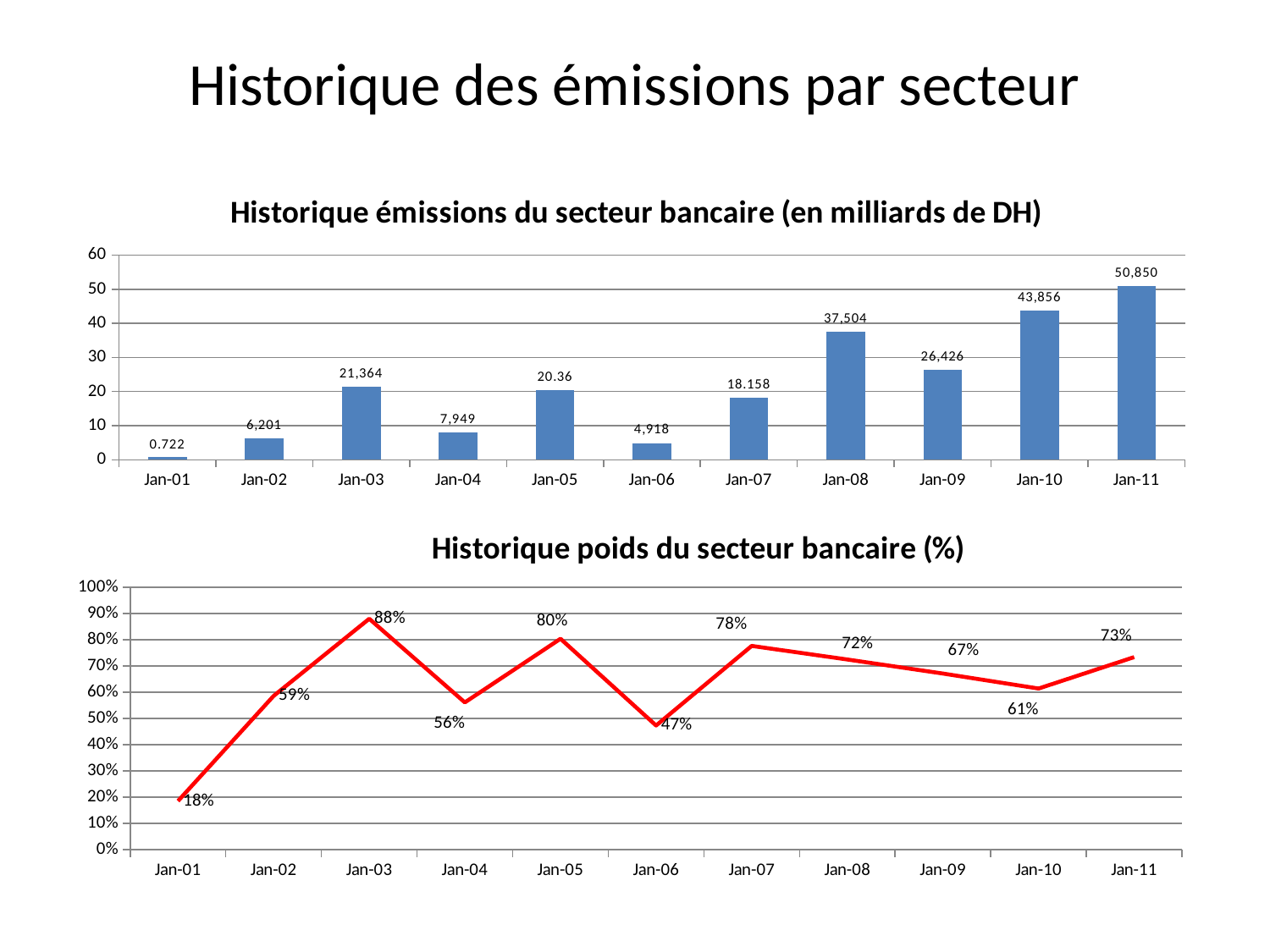
In the chart 'Historique émissions du secteur bancaire (en milliards de DH)', how many years are shown on the x axis? 11 In the chart 'Historique poids du secteur bancaire (%)', what is the difference between the values for Jan-03 and Jan-01? 70% In the chart 'Historique émissions du secteur bancaire (en milliards de DH)', which year has the lowest value? Jan-01 In the chart 'Historique poids du secteur bancaire (%)', what colour is the line? Red In the chart 'Historique émissions du secteur bancaire (en milliards de DH)', which is larger, the value for Jan-08 or the value for Jan-09? Jan-08 What kind of chart is 'Historique émissions du secteur bancaire (en milliards de DH)'? Bar chart What kind of chart is 'Historique poids du secteur bancaire (%)'? Line chart In the chart 'Historique émissions du secteur bancaire (en milliards de DH)', which year has the highest value? Jan-11 In the chart 'Historique poids du secteur bancaire (%)', what is the value for Jan-03? 88% In the chart 'Historique émissions du secteur bancaire (en milliards de DH)', what is the value for Jan-01? 0.722 In the chart 'Historique émissions du secteur bancaire (en milliards de DH)', what is the value for Jan-11? 50,850 In the chart 'Historique poids du secteur bancaire (%)', which year has the lowest value? Jan-01